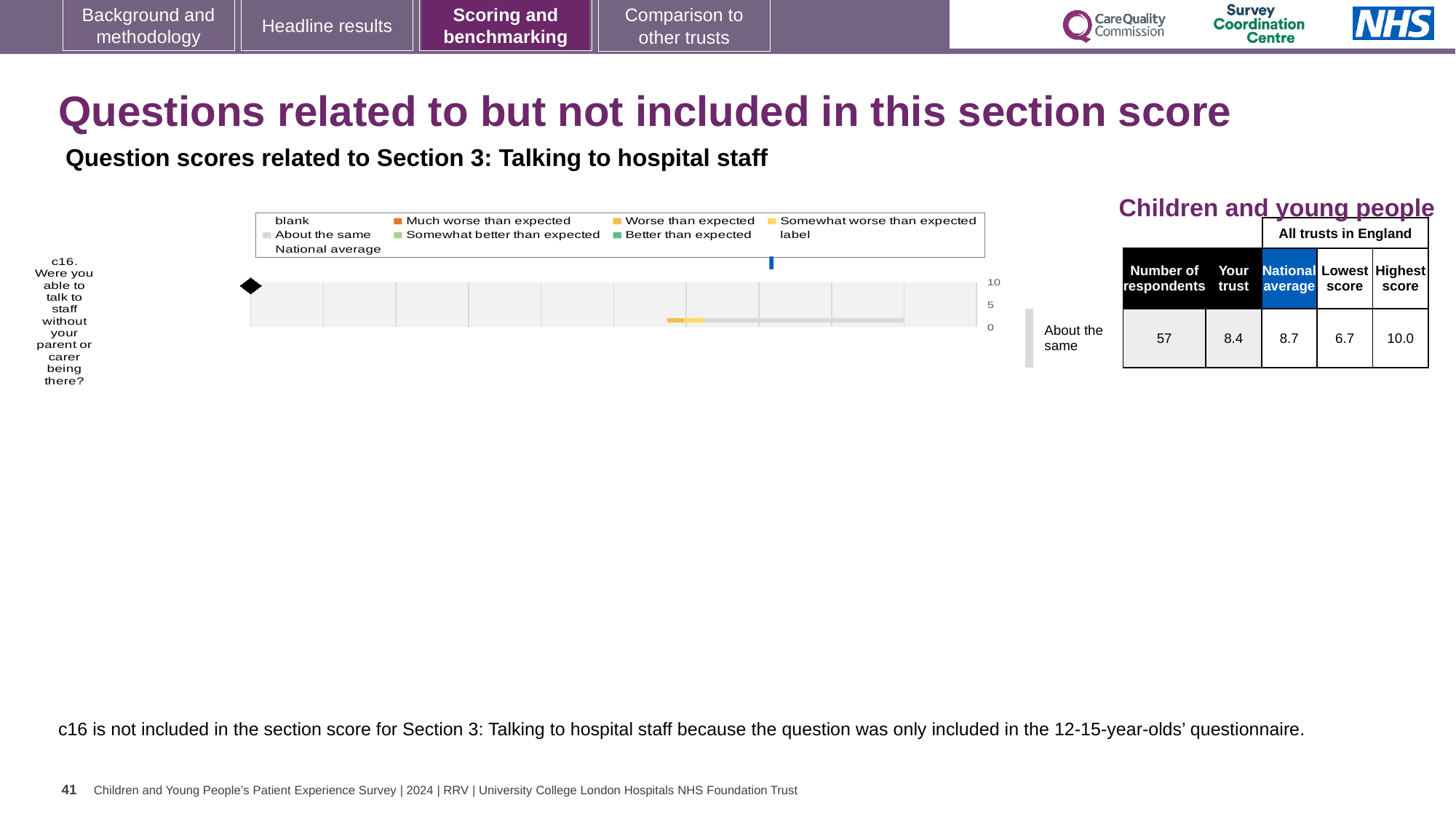
How many survey questions are plotted on the chart? 1 According to the label beside the chart, how does the trust's result for c16 compare with what was expected? About the same In the table beside the chart, what is the highest score among all trusts in England for c16? 10.0 In the table beside the chart, what is the lowest score among all trusts in England for c16? 6.7 Which question number is plotted on the chart? c16 In the table beside the chart, what is the national average score for c16? 8.7 Which is larger for c16, the 'Your trust' score or the national average? National average In the table beside the chart, what is the 'Your trust' score for c16? 8.4 What kind of chart is shown on the slide? bar chart In the table beside the chart, what is the number of respondents for c16? 57 What is the difference between the highest score and the lowest score for c16 in the table? 3.3 What is the highest value shown on the chart's axis? 10